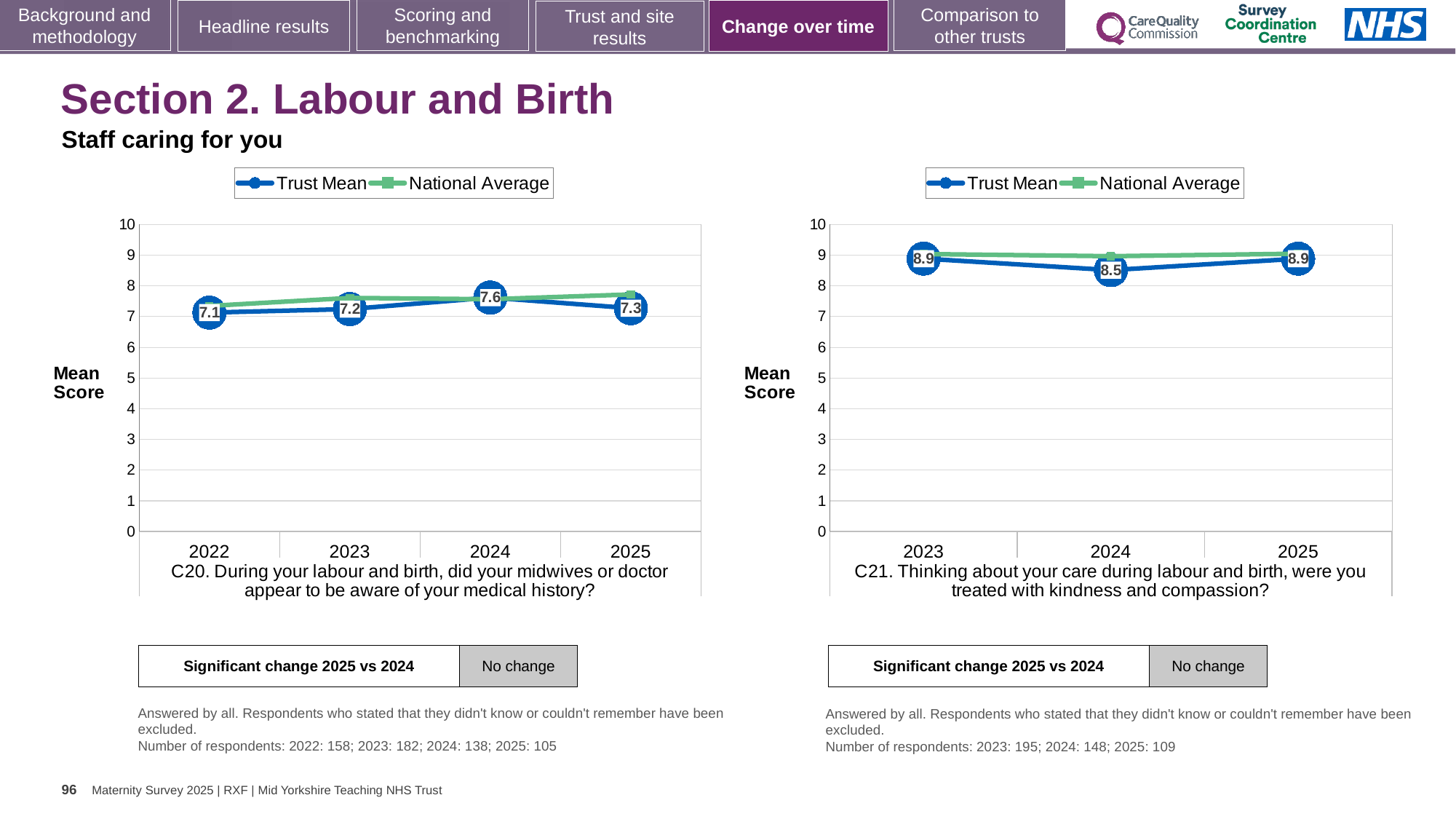
On the C20 chart (left), which year has the lowest Trust Mean? 2022 On the C20 chart (left), which year has the highest Trust Mean? 2024 On the C21 chart (right), what is the Trust Mean for 2025? 8.9 On the C20 chart (left), how many years are shown on the x axis? 4 On the C20 chart (left), what is the Trust Mean for 2024? 7.6 On the C20 chart (left), what is the Trust Mean for 2022? 7.1 On the C21 chart (right), what is the Trust Mean for 2024? 8.5 On the C20 chart (left), what is the Trust Mean for 2025? 7.3 On the C21 chart (right), which year has the lowest Trust Mean? 2024 On the C21 chart (right), how many series does the legend list? 2 What kind of chart is the C21 chart (right)? Line chart On the C20 chart (left), what is the difference between the Trust Mean for 2024 and 2025? 0.3